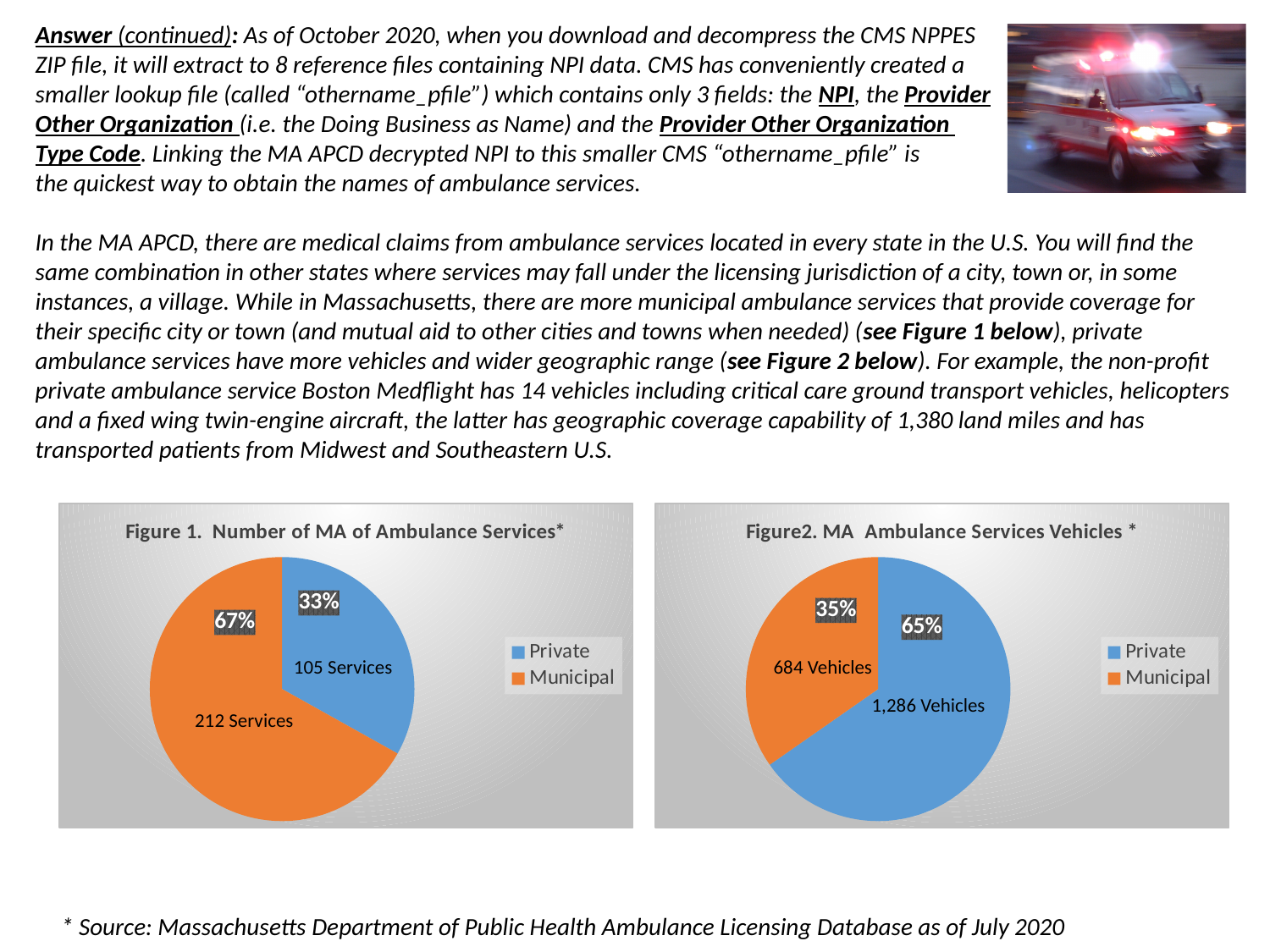
In Figure 1, what share of the pie is Municipal? 67% In Figure 1, what is the difference between the Municipal and Private service counts? 107 In Figure 2, how many vehicles are Municipal? 684 Vehicles In Figure 1, how many services are Municipal? 212 Services In Figure 2, what share of the pie is Private? 65% In Figure 2, which category has the smaller slice? Municipal In Figure 2, how many vehicles are Private? 1,286 Vehicles In Figure 1, how many services are Private? 105 Services What type of chart is Figure 1? pie chart In Figure 1, which category has the larger slice? Municipal How many entries does the legend of Figure 2 list? 2 In Figure 2, is the Private slice larger or smaller than the Municipal slice? larger